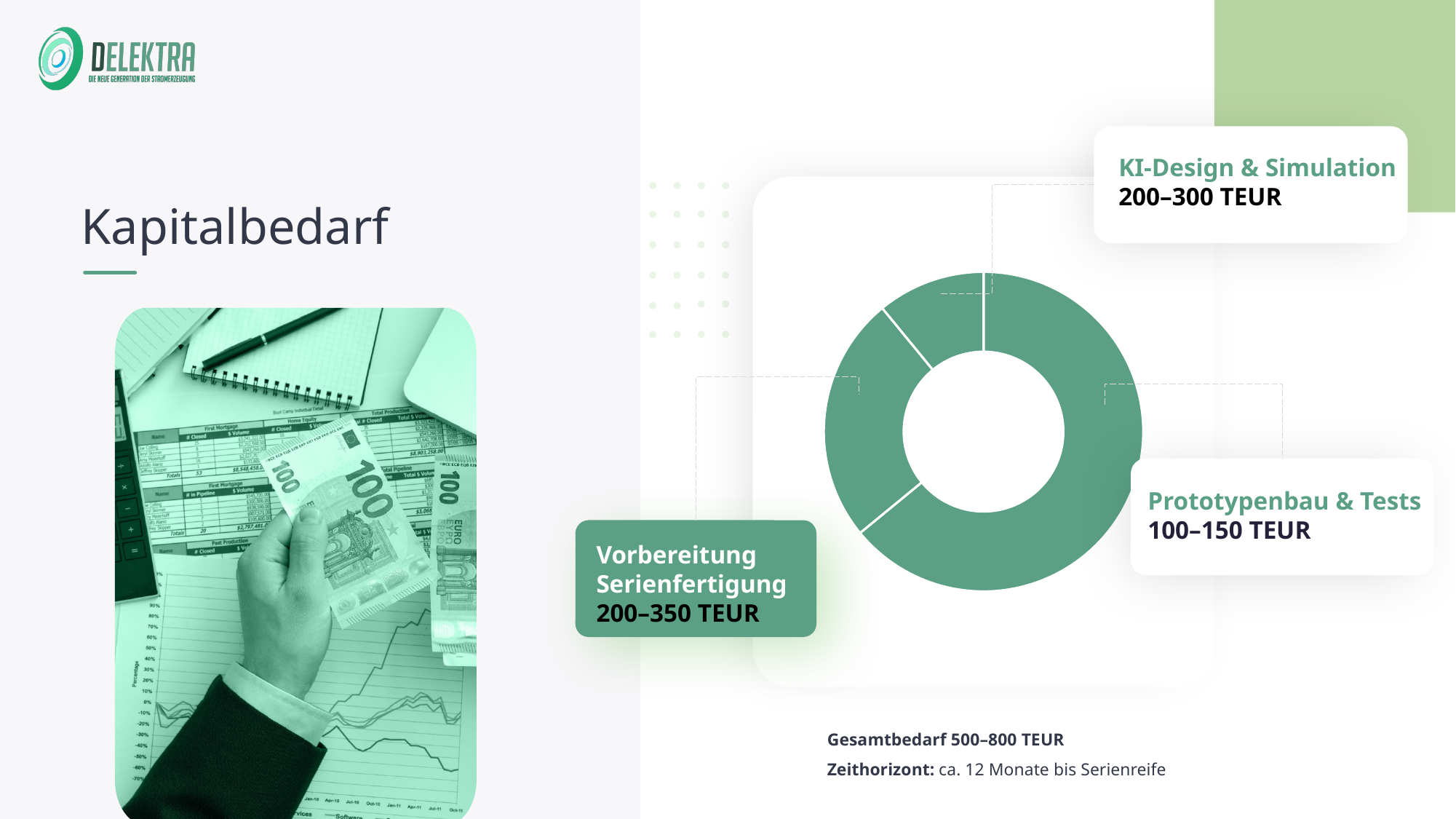
What is the capital requirement shown for Prototypenbau & Tests? 100–150 TEUR What is the total capital requirement (Gesamtbedarf) stated on the slide? 500–800 TEUR How many categories does the donut chart break the capital requirement into? 3 What is the capital requirement shown for KI-Design & Simulation? 200–300 TEUR What kind of chart is shown on the slide? Donut (pie) chart What is the title of the slide containing the chart? Kapitalbedarf What is the capital requirement shown for Vorbereitung Serienfertigung? 200–350 TEUR What time horizon (Zeithorizont) is stated below the chart? ca. 12 Monate bis Serienreife Which category has the lowest capital requirement range? Prototypenbau & Tests Which has a larger capital requirement range: KI-Design & Simulation or Prototypenbau & Tests? KI-Design & Simulation Which category has the highest upper bound of its capital requirement range? Vorbereitung Serienfertigung